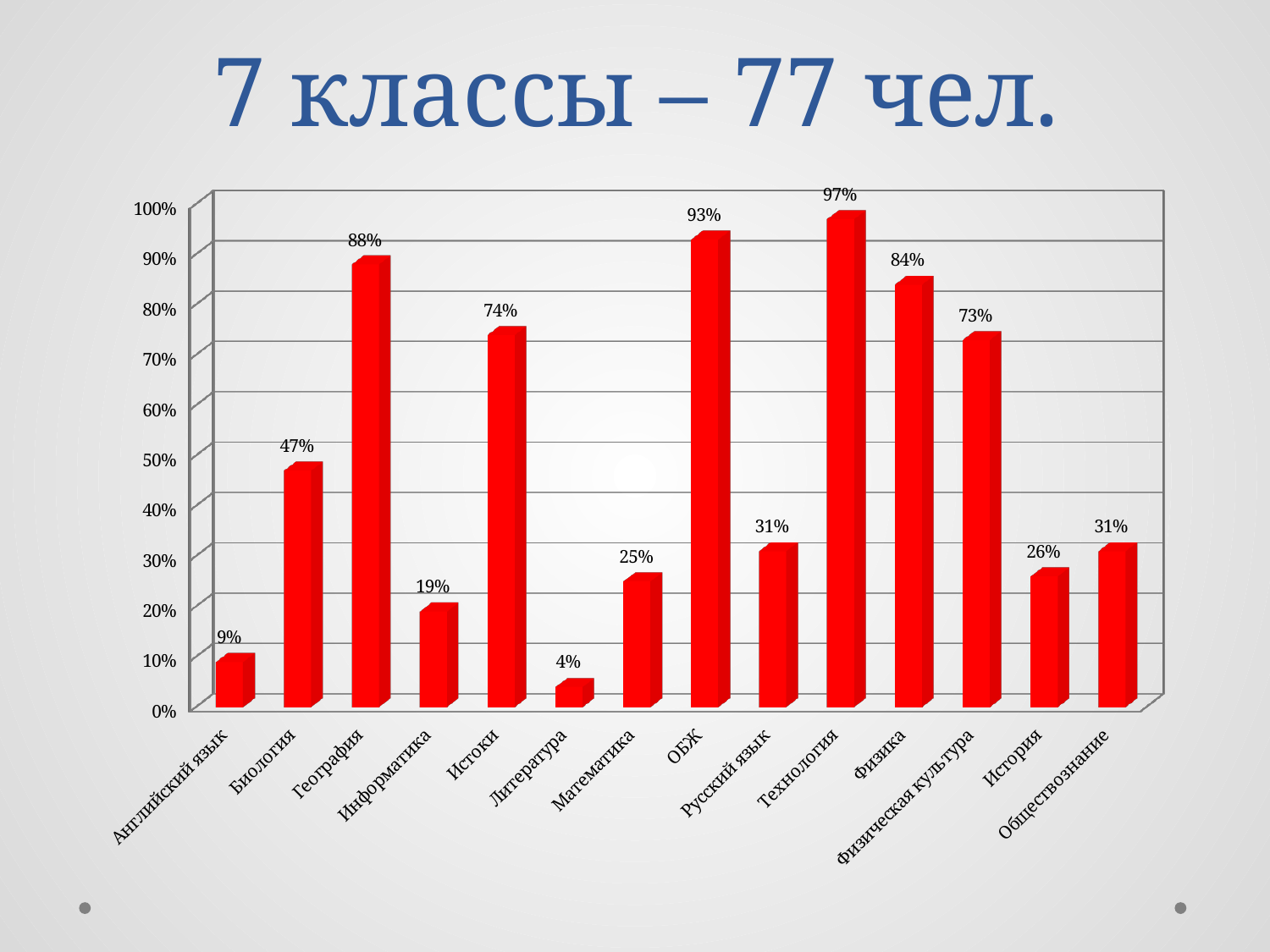
Is the value for История greater or less than 50%? less What kind of chart is shown on the slide? bar chart What is the difference between the values for ОБЖ and Физика? 9% What is the value for Физическая культура? 73% What colour are the bars in the chart? red Which category has the lowest value? Литература Which is larger, the value for Биология or the value for Истоки? Истоки What is the title of the slide? 7 классы – 77 чел. Which category has the highest value? Технология How many categories are shown on the x axis? 14 What is the value for География? 88% What is the value for Математика? 25%